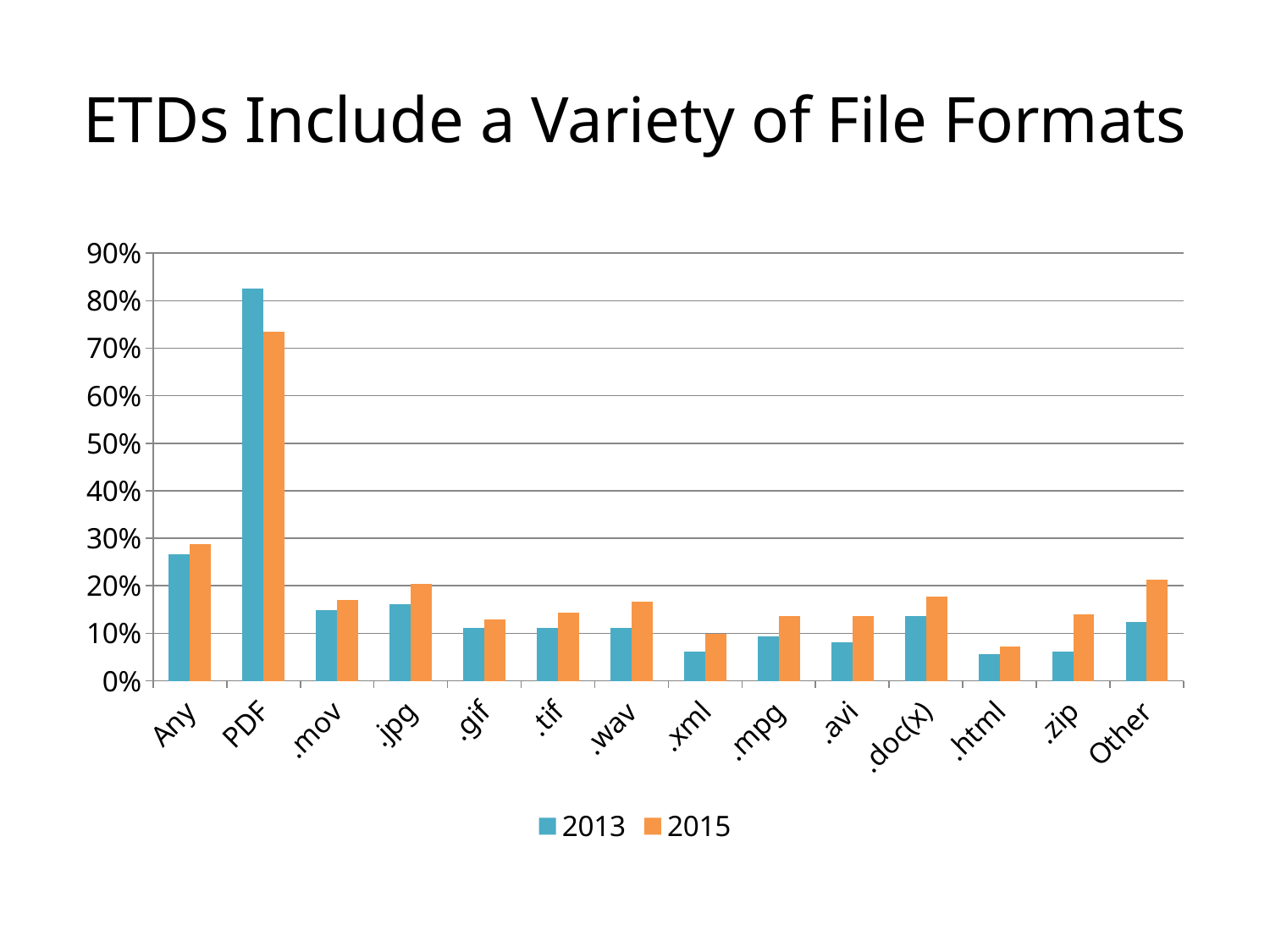
Is the 2013 value for PDF greater or less than 80%? greater What type of chart is shown on the slide? bar chart How many file format categories are shown on the x axis? 14 For PDF, which series has the larger value, 2013 or 2015? 2013 Is the 2015 value for Any greater or less than 30%? less How many series does the legend list? 2 For .zip, which series has the larger value, 2013 or 2015? 2015 Which category has the lowest value for 2015? .html Which category has the highest value for 2015? PDF What is the title of the slide? ETDs Include a Variety of File Formats Is the 2013 value for .xml greater or less than 10%? less Which category has the highest value for 2013? PDF